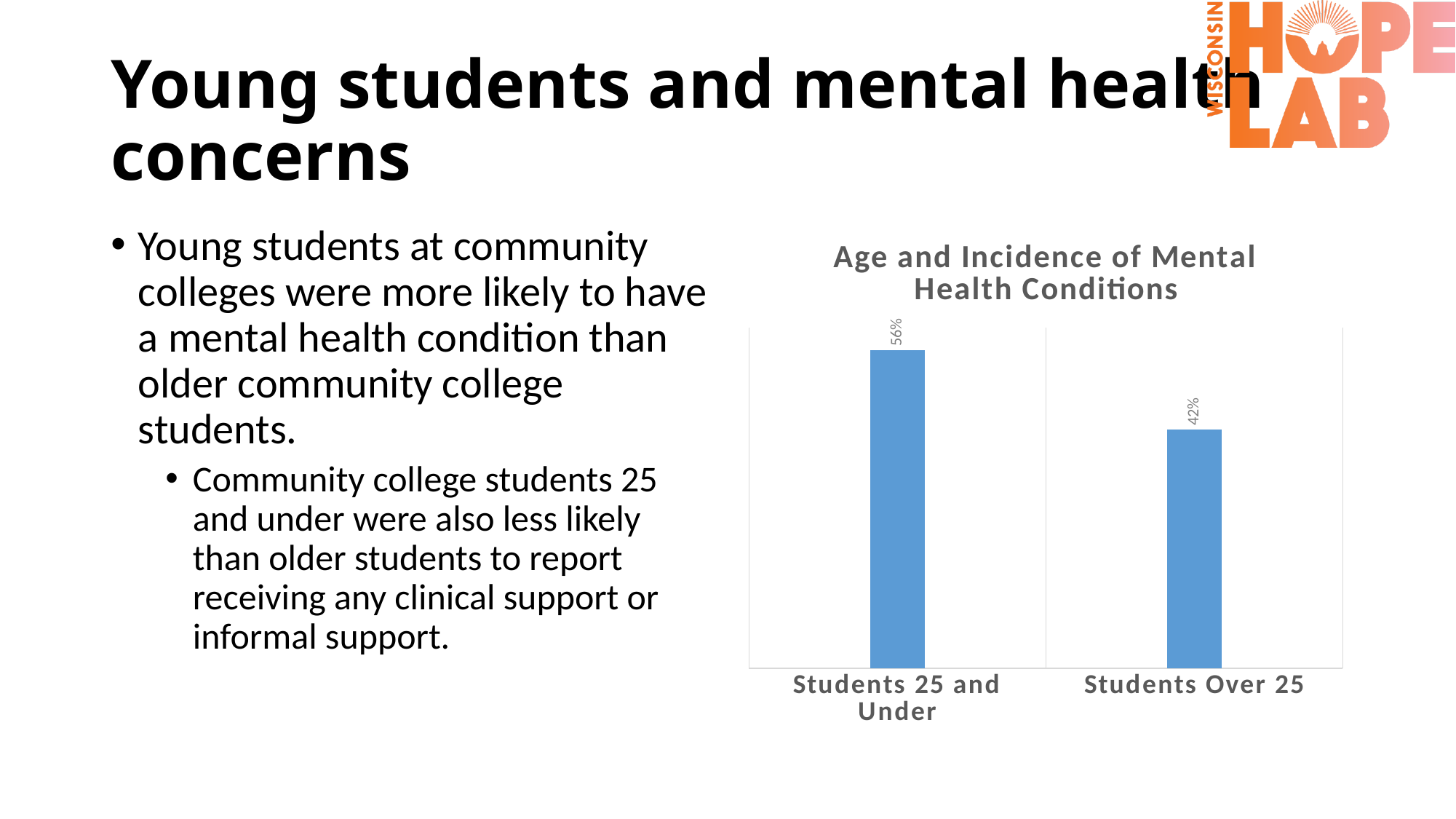
What is the difference between the values for Students 25 and Under and Students Over 25? 14% How many categories are shown in the chart? 2 What is the value for Students Over 25? 42% Do the values rise or fall from Students 25 and Under to Students Over 25? Fall What is the title of the chart? Age and Incidence of Mental Health Conditions What is the value for Students 25 and Under? 56% What kind of chart is shown on the slide? Bar chart Which category has the lowest value? Students Over 25 Which category has the highest value? Students 25 and Under What colour are the bars in the chart? Blue Which is larger, the value for Students 25 and Under or the value for Students Over 25? Students 25 and Under